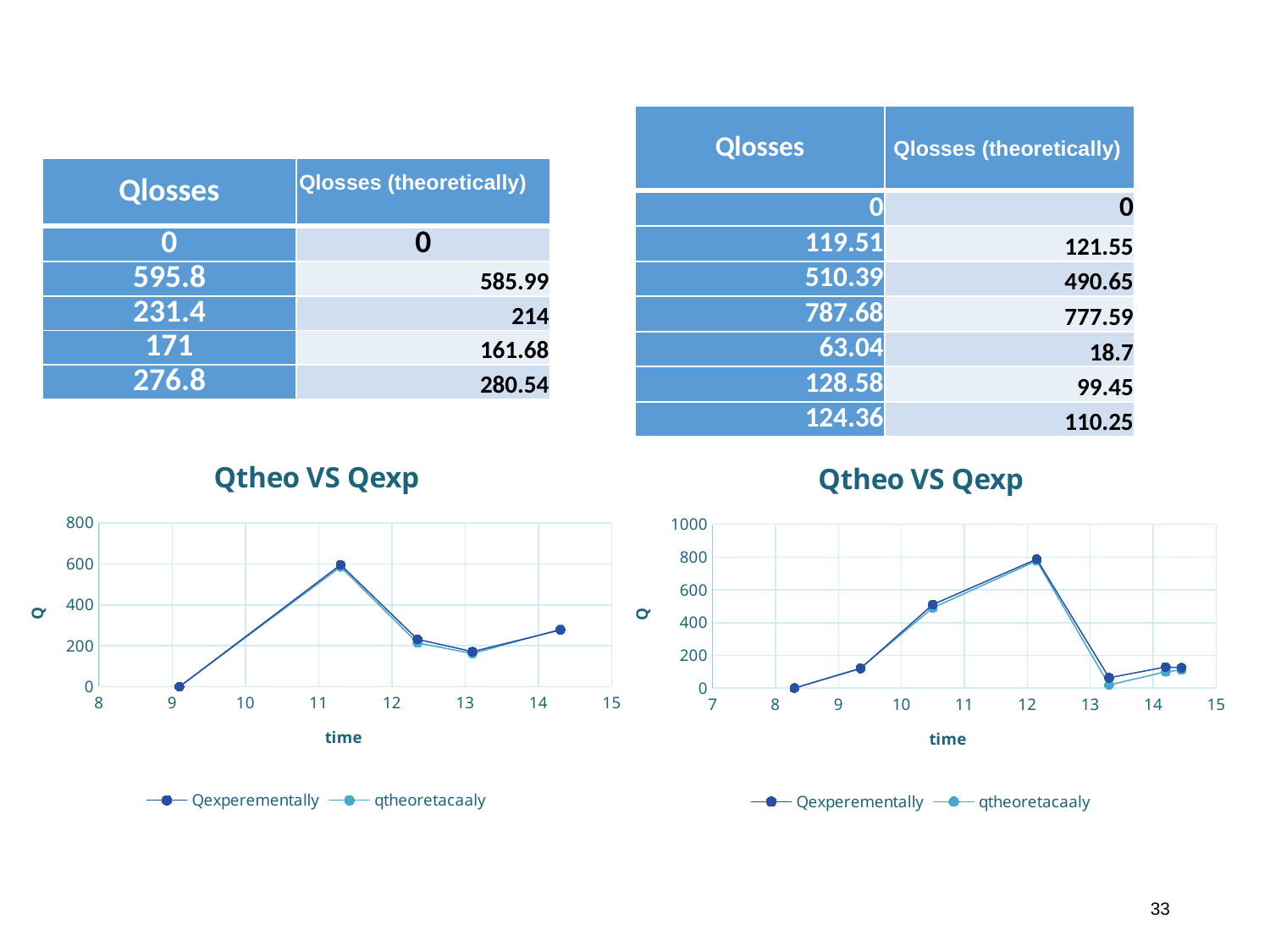
On the left chart, which is larger: the value plotted near time 11 or the value plotted near time 14? the value near time 11 What are the two legend entries on the right chart? Qexperementally and qtheoretacaaly How many data points are plotted for each series on the right chart? 7 On the left chart, do the values rise or fall between time 11 and time 13? fall On the right chart, is the highest value of Qexperementally greater or less than 600? greater How many series does the legend of the left chart list? 2 On the left chart, is the highest value of Qexperementally greater or less than 400? greater How many data points are plotted for each series on the left chart? 5 On the right chart, are the values plotted just after time 13 greater or less than 200? less On the right chart, do the values rise or fall between time 8 and time 12? rise What type of chart is the left chart titled 'Qtheo VS Qexp'? line chart What is the highest tick value shown on the y axis of the right chart? 1000